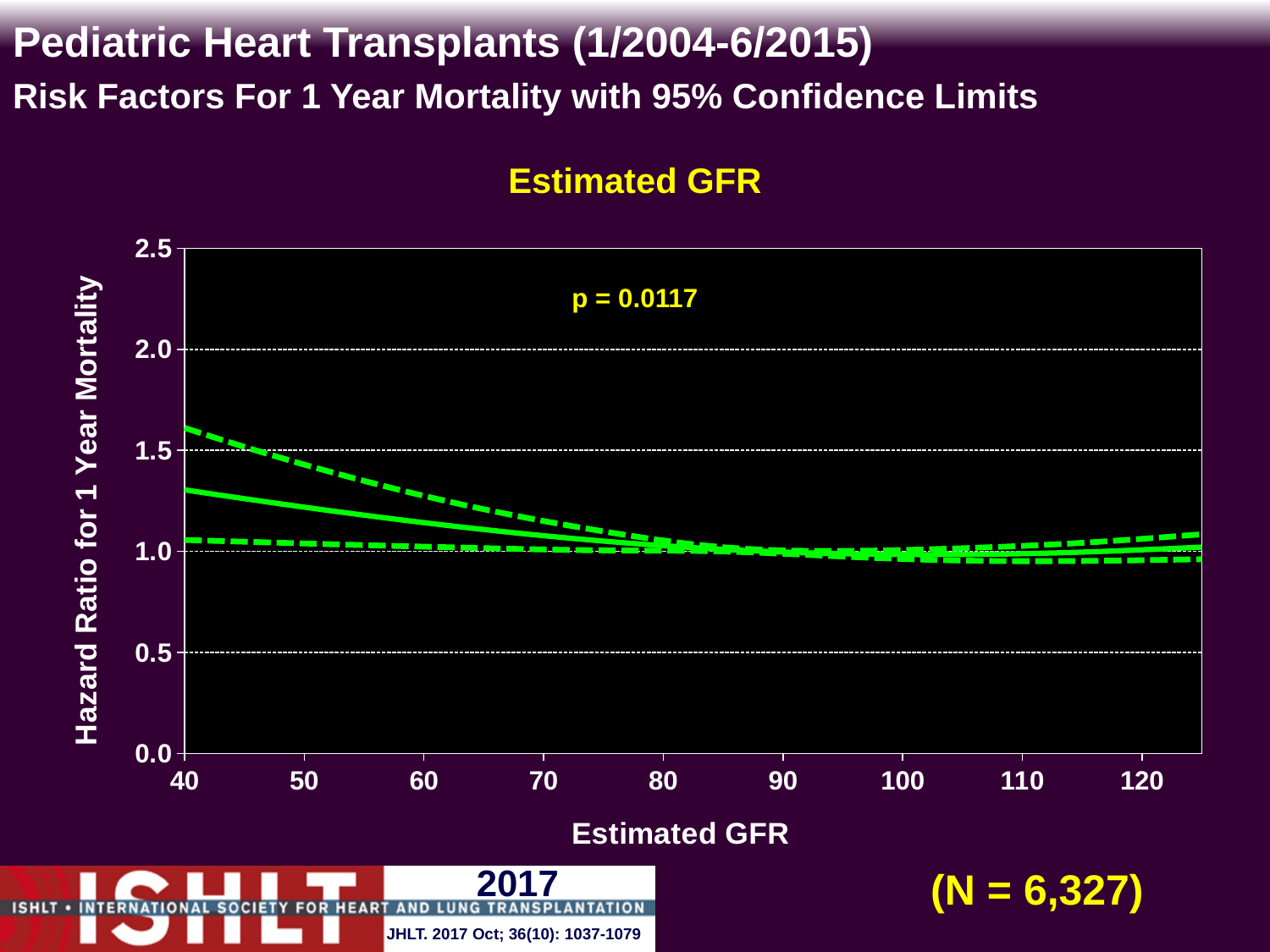
Is the hazard ratio (solid line) at an Estimated GFR of 40 greater or less than 1.0? greater Does the solid hazard ratio line rise or fall as Estimated GFR increases from 40 to 90? Fall Is the upper confidence limit (upper dashed line) at an Estimated GFR of 40 greater or less than 1.5? greater At which Estimated GFR value shown on the x axis is the solid hazard ratio line highest? 40 Is the hazard ratio (solid line) at an Estimated GFR of 100 greater or less than 1.5? less What is the label of the y axis? Hazard Ratio for 1 Year Mortality What is the sample size (N) shown on the slide? 6,327 What kind of chart is shown on the slide? Line chart What is the label of the x axis? Estimated GFR What is the p-value printed on the chart? p = 0.0117 How many lines are plotted on the chart? 3